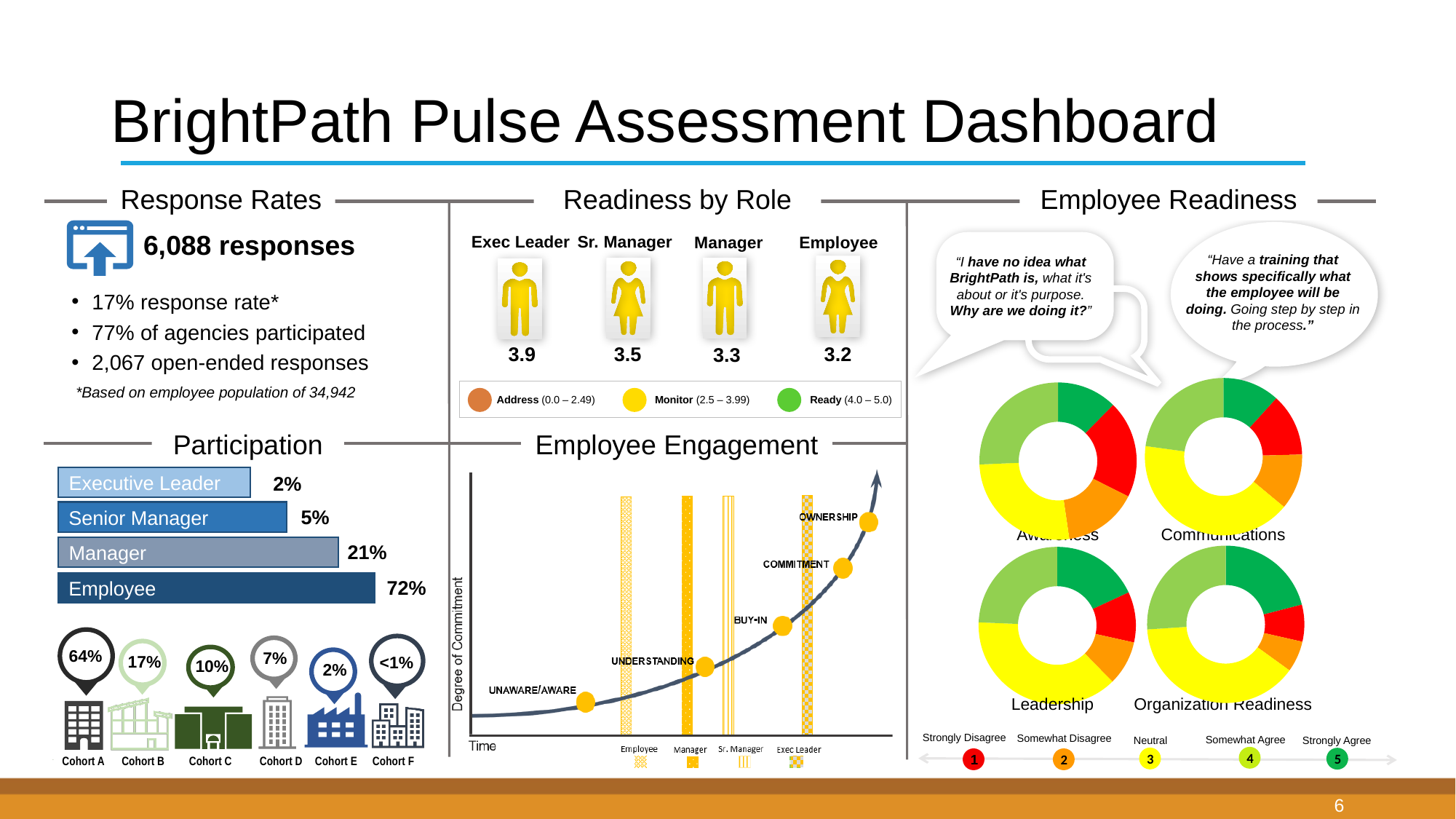
In the cohort participation graphic, what is the value for Cohort C? 10% In the Participation bar chart, what is the difference between the Employee and Manager values? 51% In the Participation bar chart, what is the value for Manager? 21% How many categories does the Participation bar chart show? 4 In the Readiness by Role section, what is the difference between the Exec Leader and Employee scores? 0.7 In the Participation bar chart, which category has the lowest value? Executive Leader In the Participation bar chart, what is the value for Senior Manager? 5% In the Readiness by Role section, what is the readiness score for Sr. Manager? 3.5 In the Participation bar chart, which category has the highest value? Employee In the Readiness by Role section, which role has the highest readiness score? Exec Leader What kind of chart is the Participation chart? bar chart In the cohort participation graphic, which cohort has the highest value? Cohort A